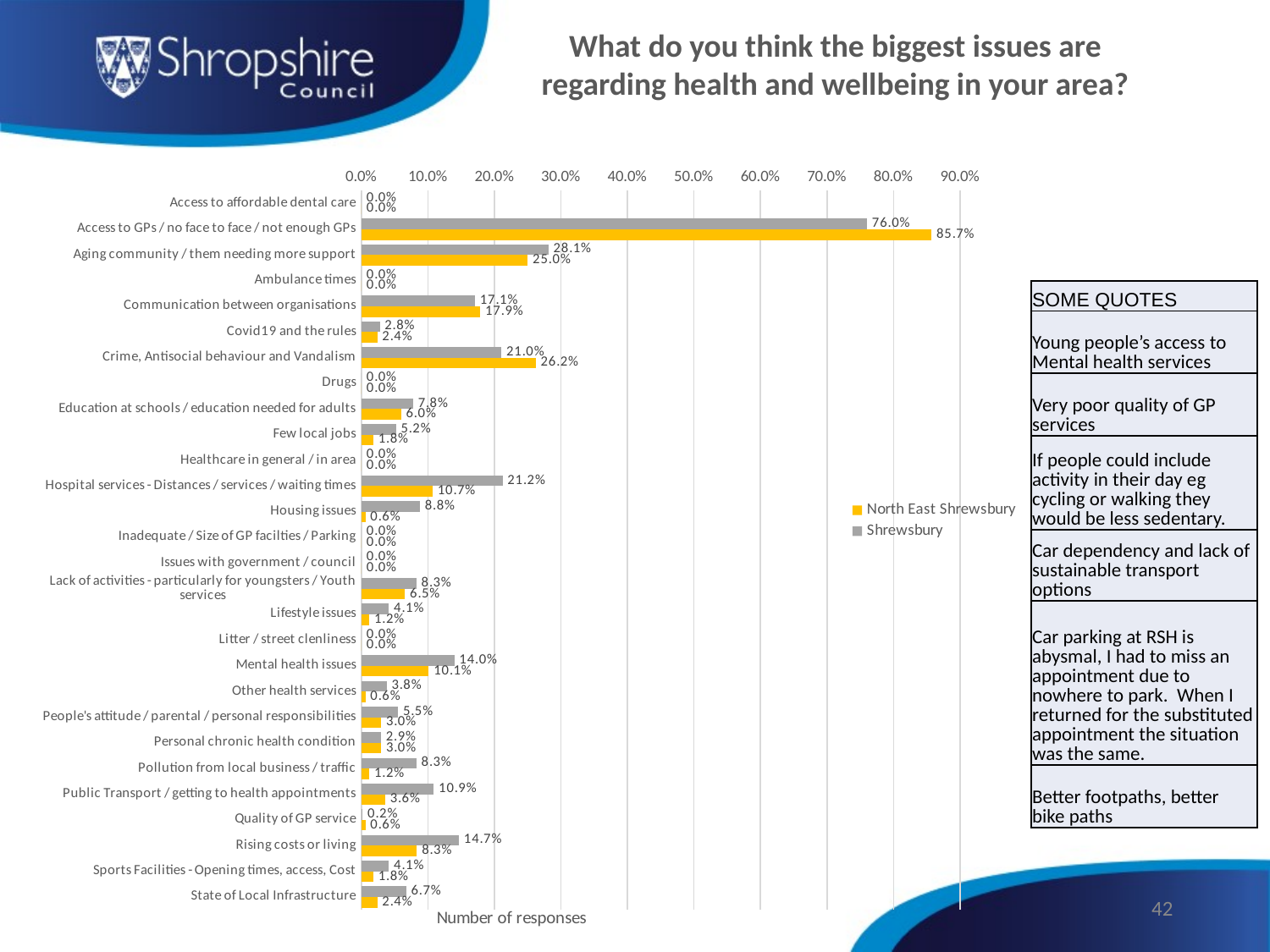
What is the value for North East Shrewsbury for 'Access to GPs / no face to face / not enough GPs'? 85.7% Which colour represents North East Shrewsbury in the chart? Yellow For 'Crime, Antisocial behaviour and Vandalism', which series has the larger value? North East Shrewsbury For 'Housing issues', which series has the larger value? Shrewsbury Which category has the highest value for Shrewsbury? Access to GPs / no face to face / not enough GPs What is the value for Shrewsbury for 'Rising costs or living'? 14.7% What is the difference between the Shrewsbury and North East Shrewsbury values for 'Public Transport / getting to health appointments'? 7.3% Is the Shrewsbury value for 'Aging community / them needing more support' greater or less than 20.0%? greater What is the difference between the North East Shrewsbury and Shrewsbury values for 'Access to GPs / no face to face / not enough GPs'? 9.7% What is the value for Shrewsbury for 'Hospital services - Distances / services / waiting times'? 21.2% What kind of chart is shown on the slide? Bar chart How many series does the legend list? 2